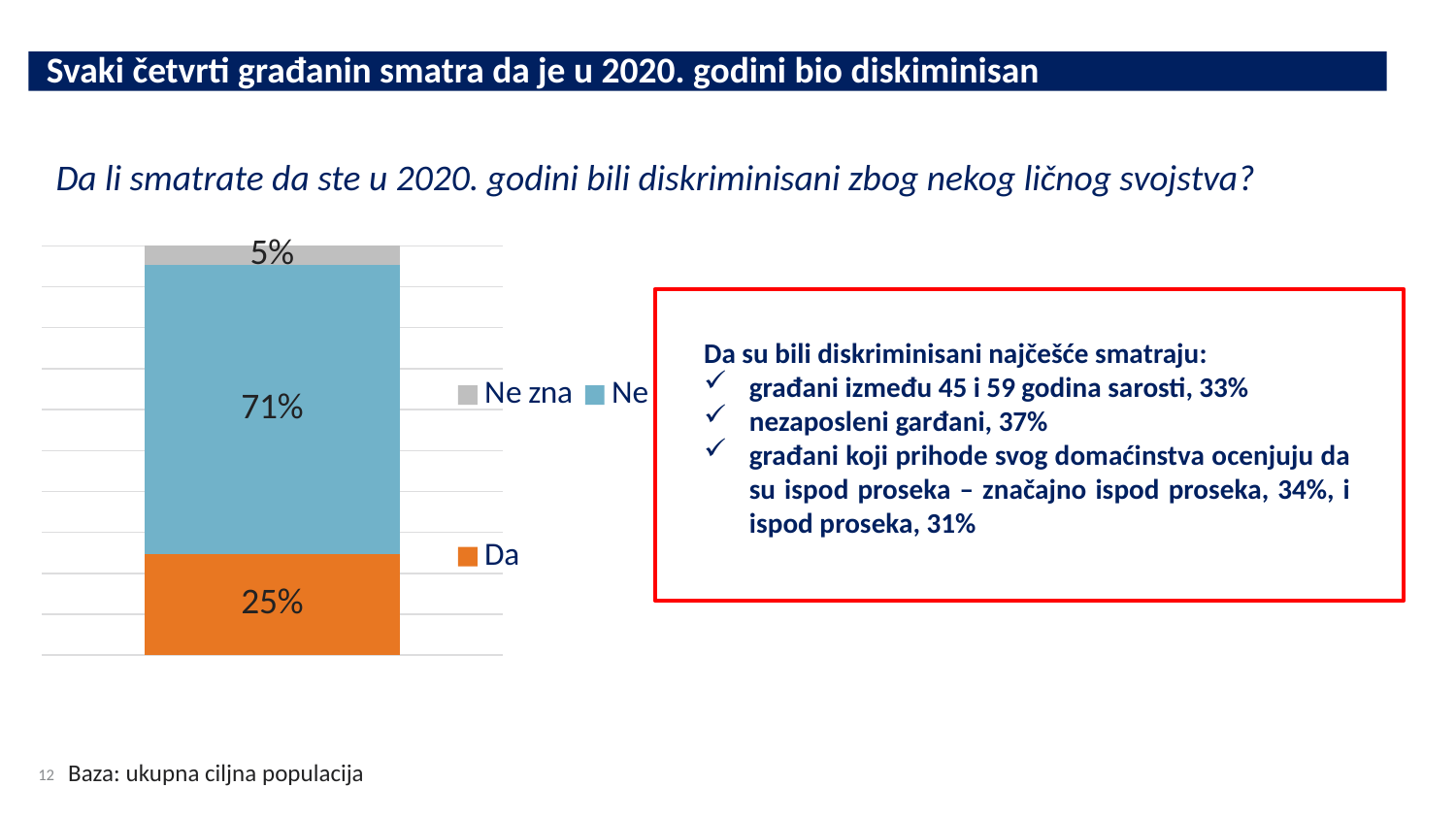
What percentage of respondents answered "Da" in the stacked bar chart? 25% What colour is the "Da" segment in the stacked bar? Orange Which segment is larger, "Da" or "Ne zna"? Da What percentage of respondents answered "Ne" in the stacked bar chart? 71% Which response has the smallest share in the stacked bar? Ne zna How many series does the legend list? 3 What is the difference in percentage points between the "Ne" and "Da" segments? 46 What colour is the "Ne zna" segment in the stacked bar? Grey What kind of chart is shown on the slide? Stacked bar chart What is the total of the three segments in the stacked bar? 101% Which response has the largest share in the stacked bar? Ne What percentage of respondents answered "Ne zna" in the stacked bar chart? 5%